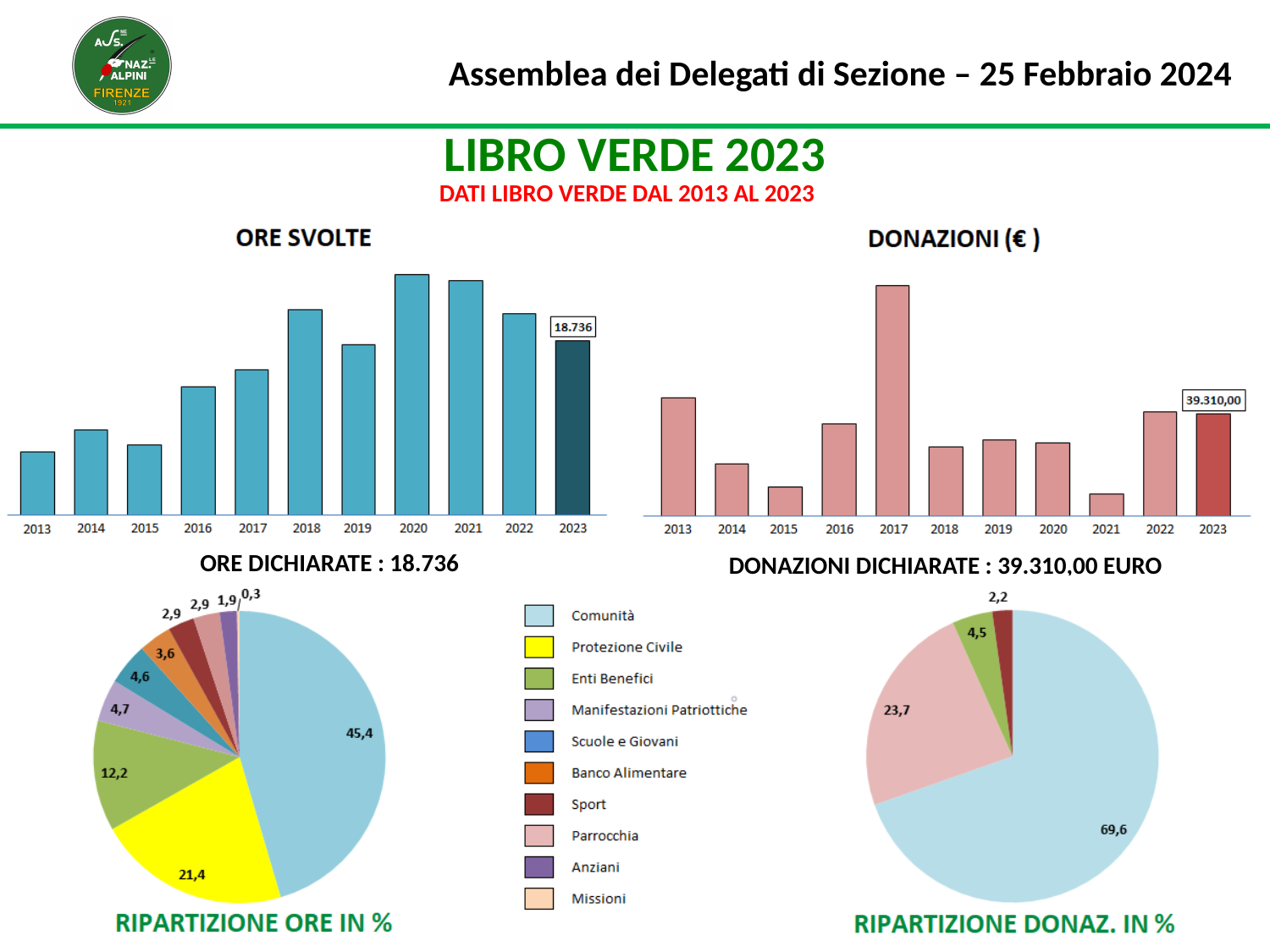
In the ORE SVOLTE chart, is the bar for 2022 or 2023 taller? 2022 In the RIPARTIZIONE ORE IN % pie chart, what share is shown for Protezione Civile (yellow)? 21,4 In the RIPARTIZIONE DONAZ. IN % pie chart, what share is shown for Parrocchia? 23,7 What kind of chart is the DONAZIONI (€) chart? bar chart How many slices does the RIPARTIZIONE DONAZ. IN % pie chart have? 4 In the RIPARTIZIONE DONAZ. IN % pie chart, what is the difference between the largest slice (69,6) and the Parrocchia slice (23,7)? 45,9 How many years are shown on the x axis of the ORE SVOLTE chart? 11 In the DONAZIONI (€) chart, which year has the highest bar? 2017 In the DONAZIONI (€) chart, what value is labelled for 2023? 39.310,00 In the DONAZIONI (€) chart, which year has the lowest bar? 2021 In the ORE SVOLTE chart, which year has the highest bar? 2020 In the ORE SVOLTE chart, what value is labelled for 2023? 18.736